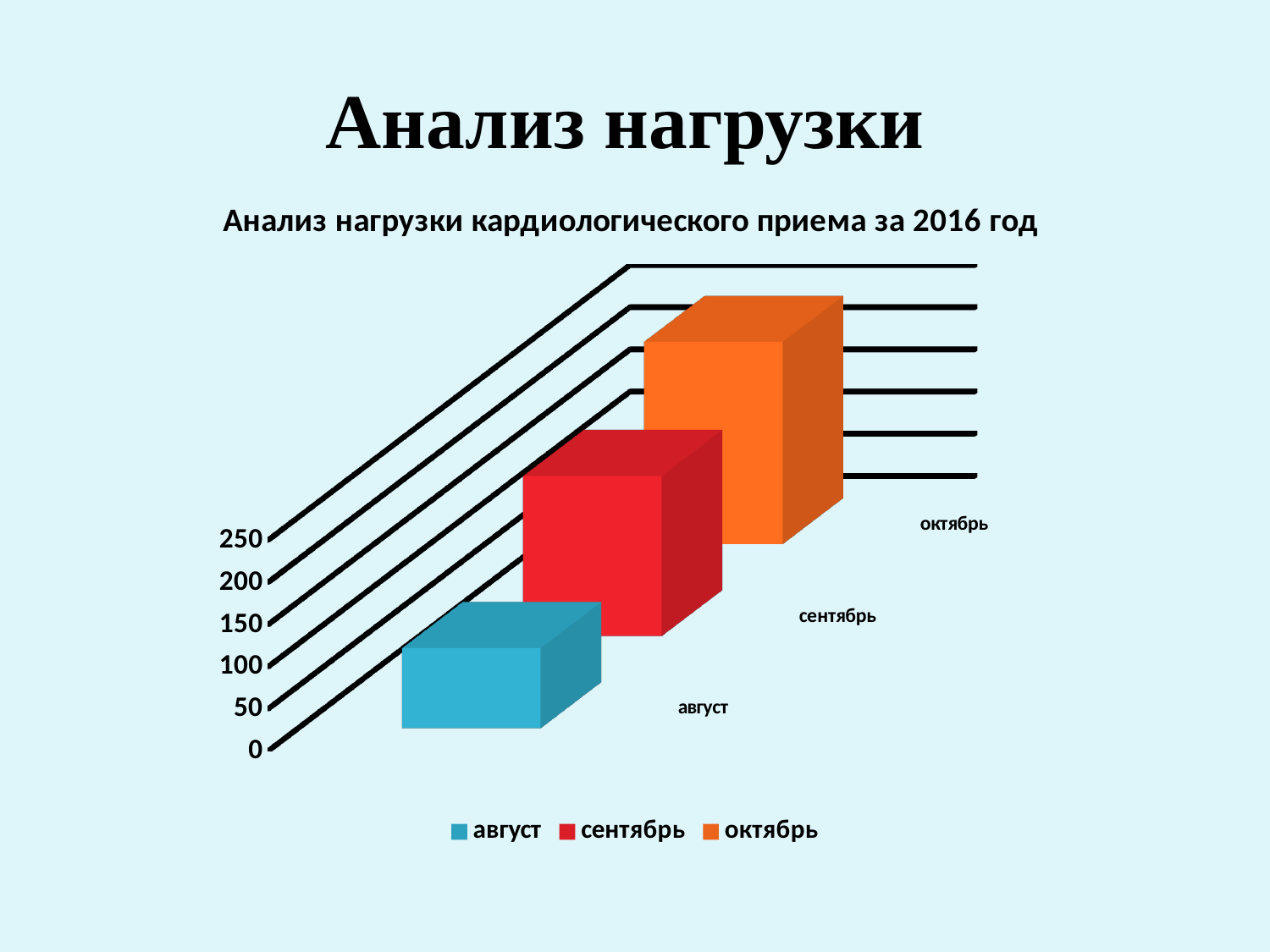
Is the value for август greater or less than 150? less Which is larger, the value for сентябрь or the value for август? сентябрь Do the values rise or fall from август to октябрь? rise How many entries does the legend list? 3 Which month has the lowest value in the chart? август Is the value for октябрь greater or less than 150? greater What is the title of the chart? Анализ нагрузки кардиологического приема за 2016 год Which month has the highest value in the chart? октябрь Which is larger, the value for октябрь or the value for сентябрь? октябрь Is the value for сентябрь greater or less than 100? greater What kind of chart is shown on the slide? bar chart How many categories (months) are plotted in the chart? 3